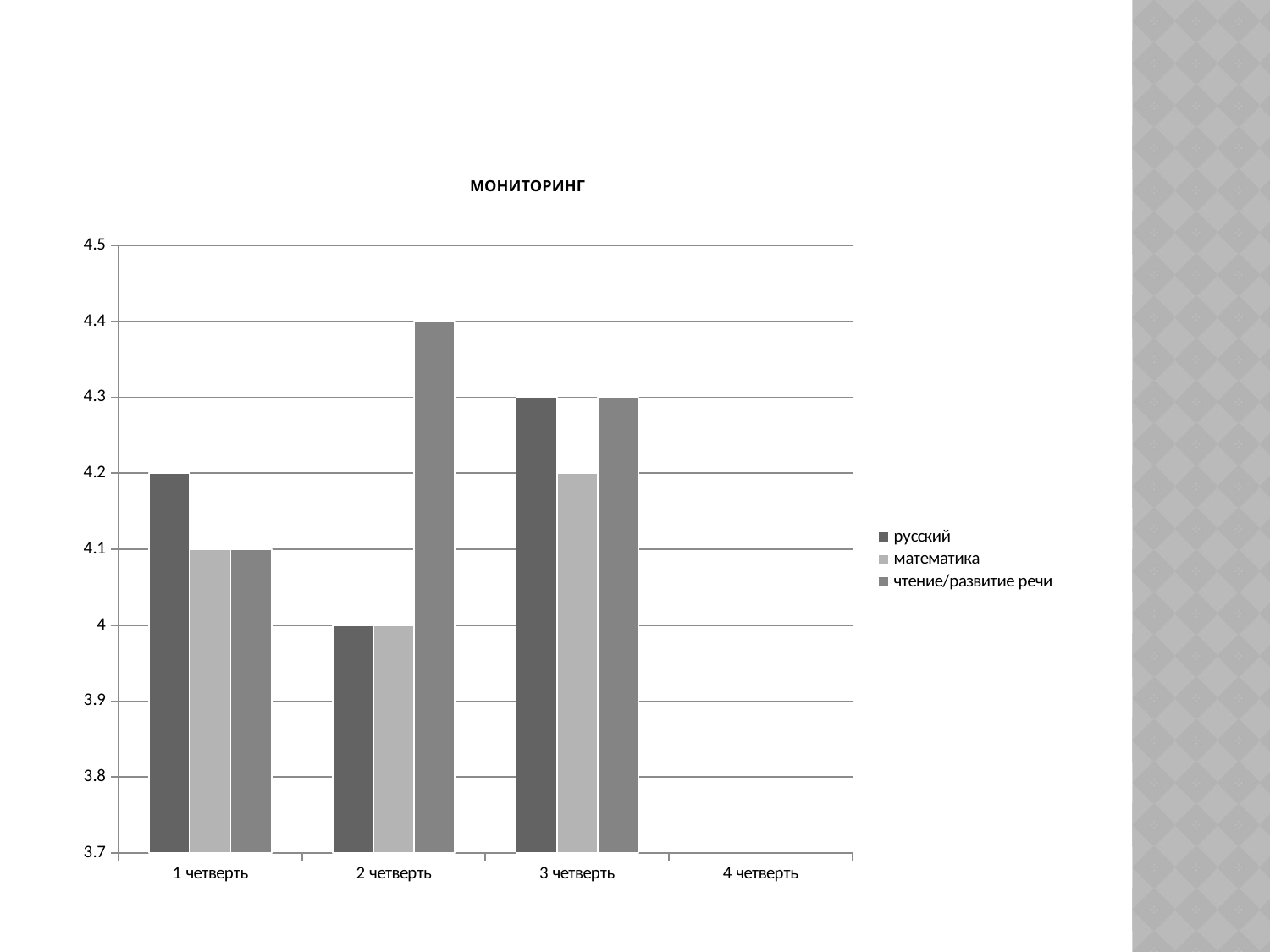
How many categories are shown on the x axis? 4 In which quarter is the value for чтение/развитие речи highest? 2 четверть Which is larger in 1 четверть: русский or математика? русский What is the value for русский in 1 четверть? 4.2 What type of chart is shown on the slide? bar chart How many series does the legend list? 3 What is the value for чтение/развитие речи in 2 четверть? 4.4 What is the value for математика in 3 четверть? 4.2 What is the title of the chart? МОНИТОРИНГ Does the value for русский rise or fall from 2 четверть to 3 четверть? rise What is the difference between чтение/развитие речи and математика in 2 четверть? 0.4 In which quarter is the value for русский lowest? 2 четверть